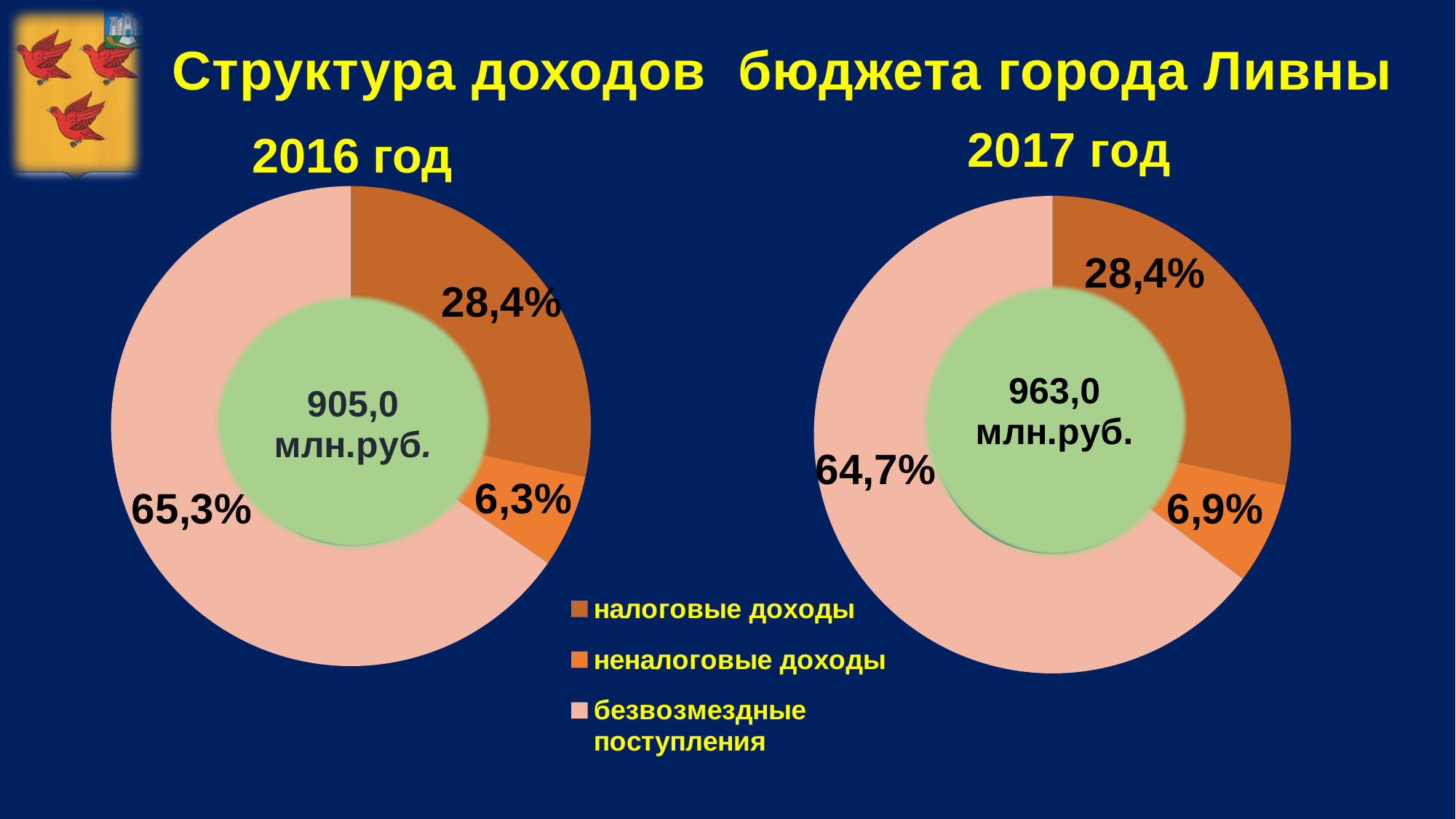
Which is larger: the share of неналоговые доходы in the 2016 год chart or in the 2017 год chart? 2017 год What total value is shown in the centre of the 2017 год chart? 963,0 млн.руб. In the 2017 год chart, what share do неналоговые доходы have? 6,9% In the 2017 год chart, what share do налоговые доходы have? 28,4% How many categories does the legend list? 3 What is the difference between the share of безвозмездные поступления in the 2016 год chart and in the 2017 год chart? 0,6% What kind of chart is the 2016 год chart? doughnut chart In the 2016 год chart, what share do безвозмездные поступления have? 65,3% What total value is shown in the centre of the 2016 год chart? 905,0 млн.руб. In the 2017 год chart, which category has the smallest share? неналоговые доходы In the 2016 год chart, which category has the largest share? безвозмездные поступления